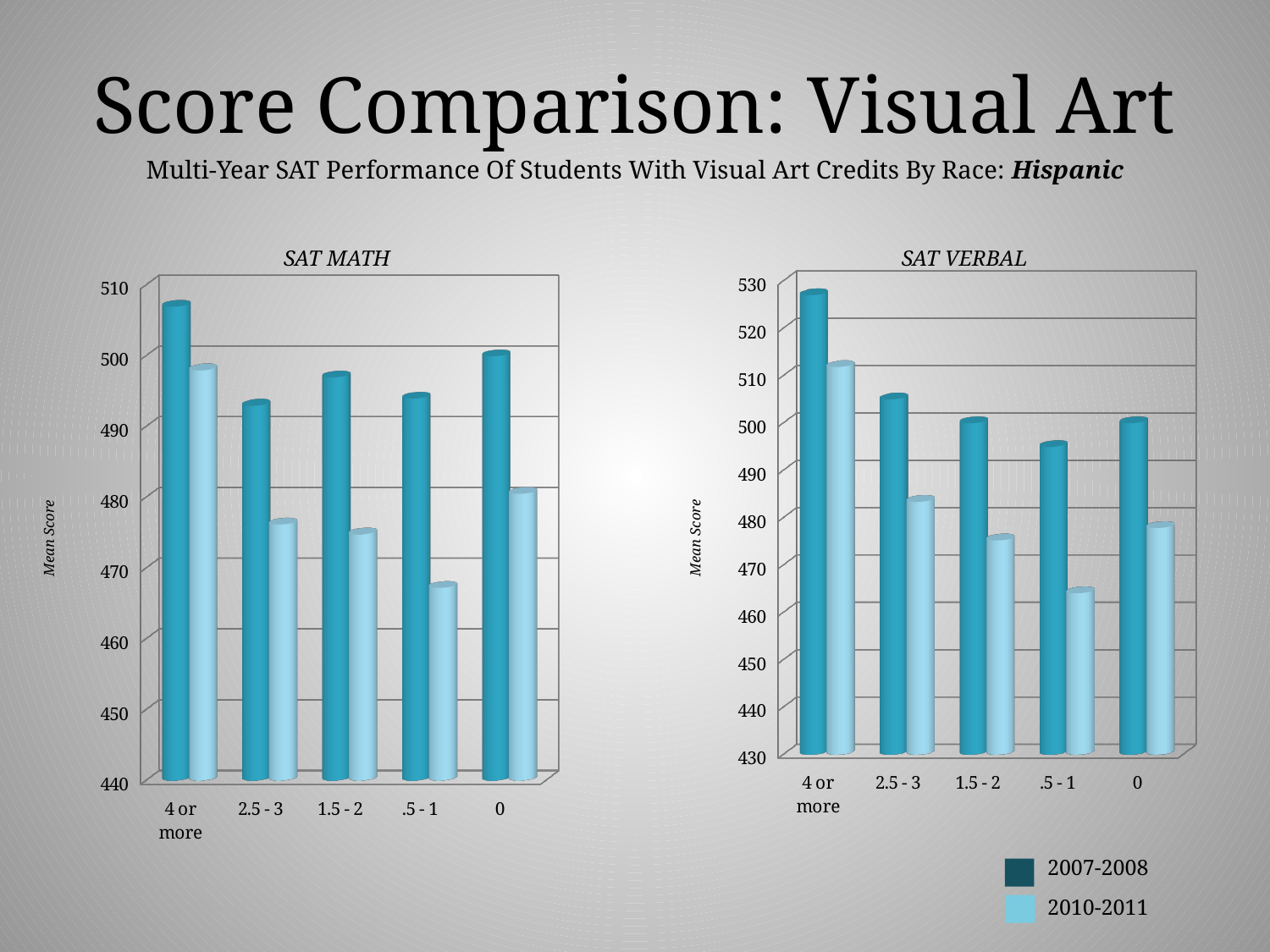
What is the label on the vertical axis of the SAT MATH chart? Mean Score How many series does the legend list? 2 In the SAT MATH chart, which category has the lowest 2010-2011 score? .5 - 1 How many credit categories are shown on the x axis of the SAT VERBAL chart? 5 In the SAT MATH chart, is the 2007-2008 value for "4 or more" greater or less than 500? greater In the SAT MATH chart, which category has the highest 2007-2008 score? 4 or more In the SAT VERBAL chart, is the 2007-2008 value for "4 or more" greater or less than 520? greater In the SAT VERBAL chart, for the "2.5 - 3" category, which series has the larger value, 2007-2008 or 2010-2011? 2007-2008 In the SAT VERBAL chart, which category has the lowest 2010-2011 score? .5 - 1 In the SAT MATH chart, is the 2010-2011 value for ".5 - 1" greater or less than 470? less What kind of chart is the SAT MATH chart? bar chart In the SAT VERBAL chart, which category has the highest 2007-2008 score? 4 or more